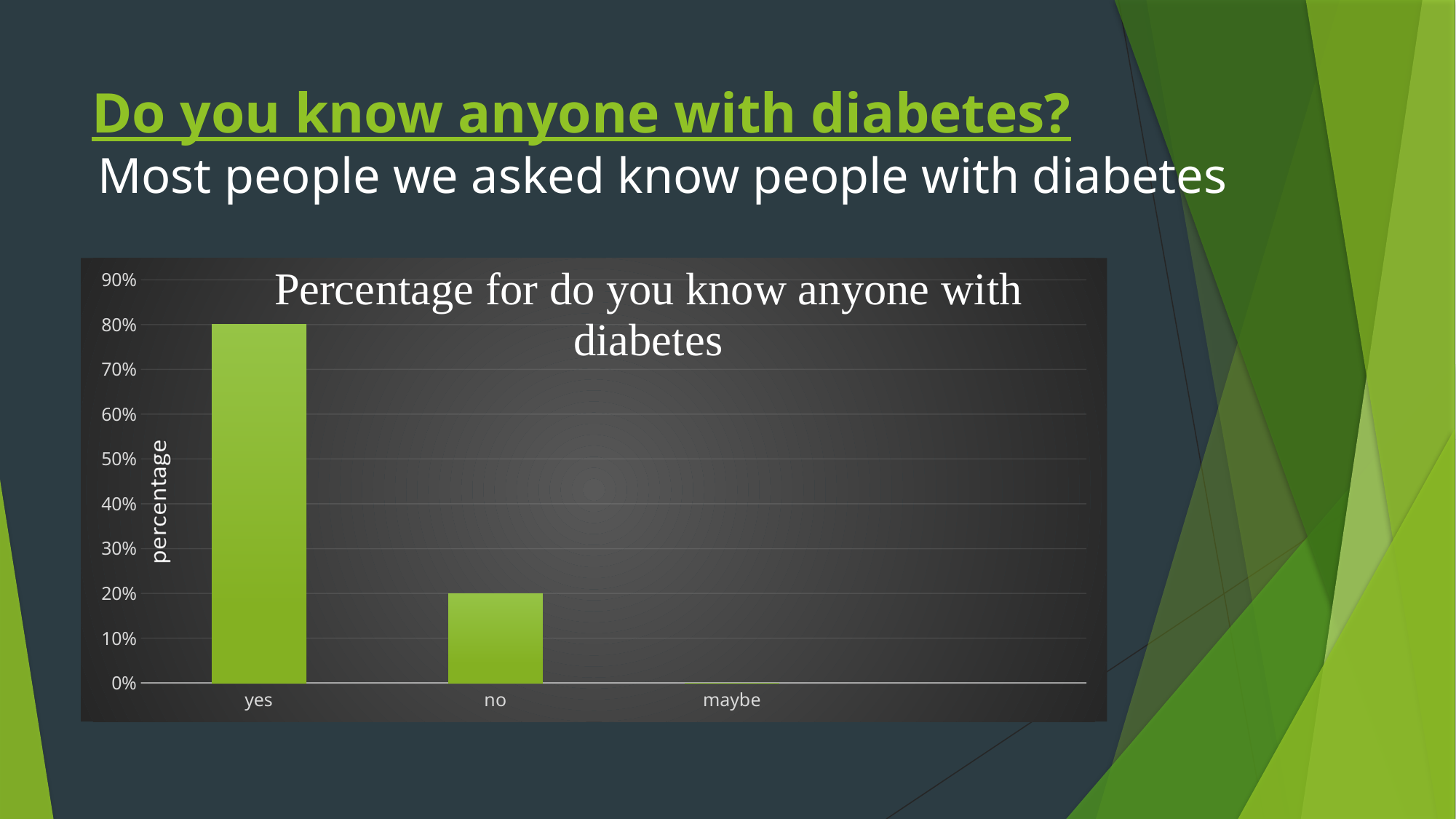
What is the label on the vertical axis of the chart? percentage What type of chart is shown on the slide? bar chart What is the percentage for the 'maybe' category? 0% What is the percentage for the 'yes' category? 80% Which category has the highest percentage? yes What is the difference between the percentages for 'yes' and 'no'? 60% Which is larger, the percentage for 'no' or the percentage for 'maybe'? no How many categories are shown on the x axis of the chart? 3 What is the percentage for the 'no' category? 20% Which category has the lowest percentage? maybe What is the title of the chart? Percentage for do you know anyone with diabetes Is the value for 'yes' greater or less than 50%? greater